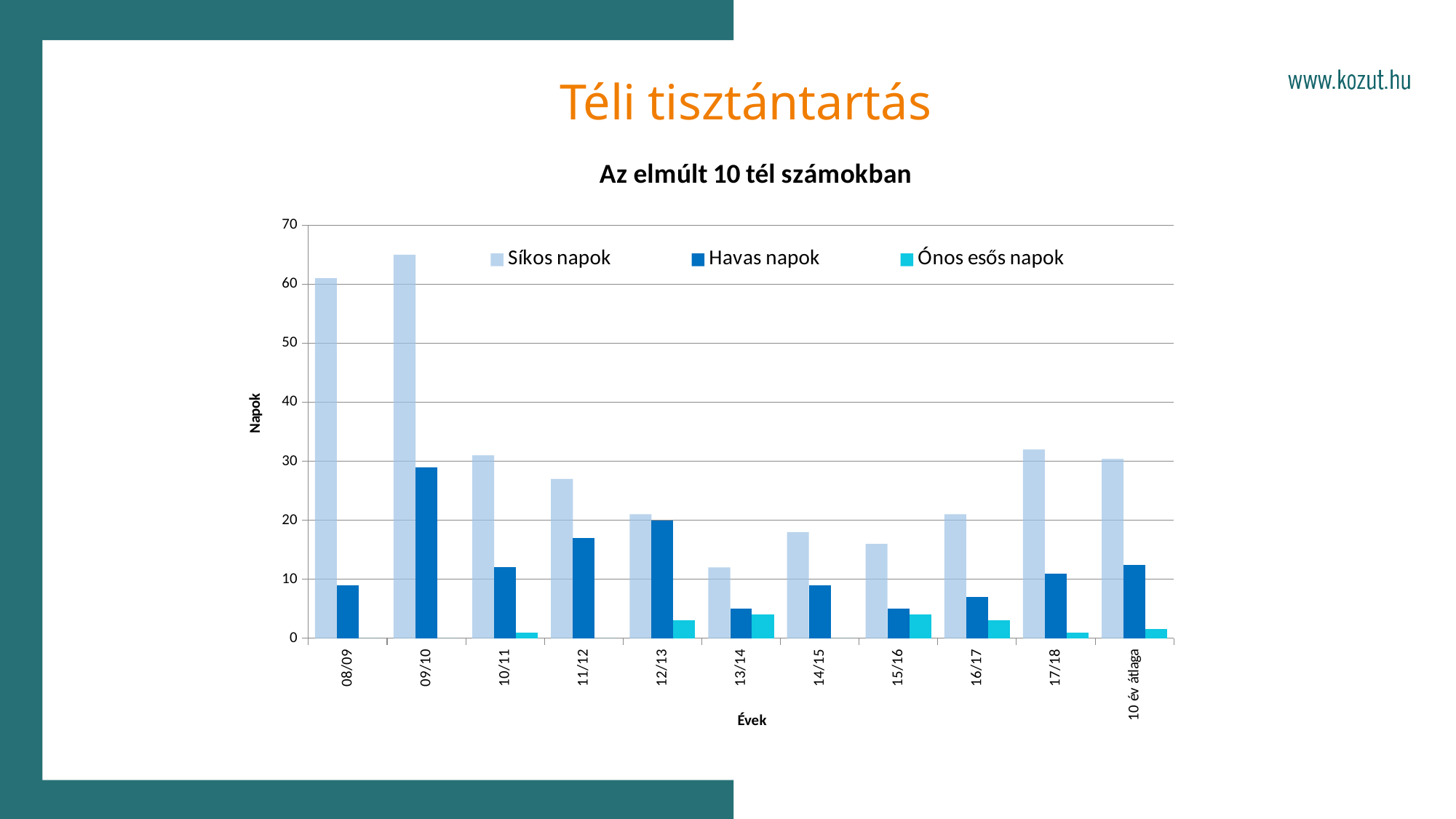
Which category has the lowest value for Síkos napok? 13/14 How many categories are shown along the x axis? 11 Which is larger: Síkos napok in 10/11 or Síkos napok in 11/12? 10/11 Is the value for Havas napok in 11/12 greater or less than 20? less Is the value for Síkos napok in 13/14 greater or less than 20? less Which category has the highest value for Havas napok? 09/10 What kind of chart is shown on the slide? bar chart Is the value for Síkos napok in 08/09 greater or less than 50? greater Do the Síkos napok values rise or fall from 08/09 to 13/14? fall Which category has the highest value for Síkos napok? 09/10 How many series does the legend list? 3 What is the title of the chart? Az elmúlt 10 tél számokban